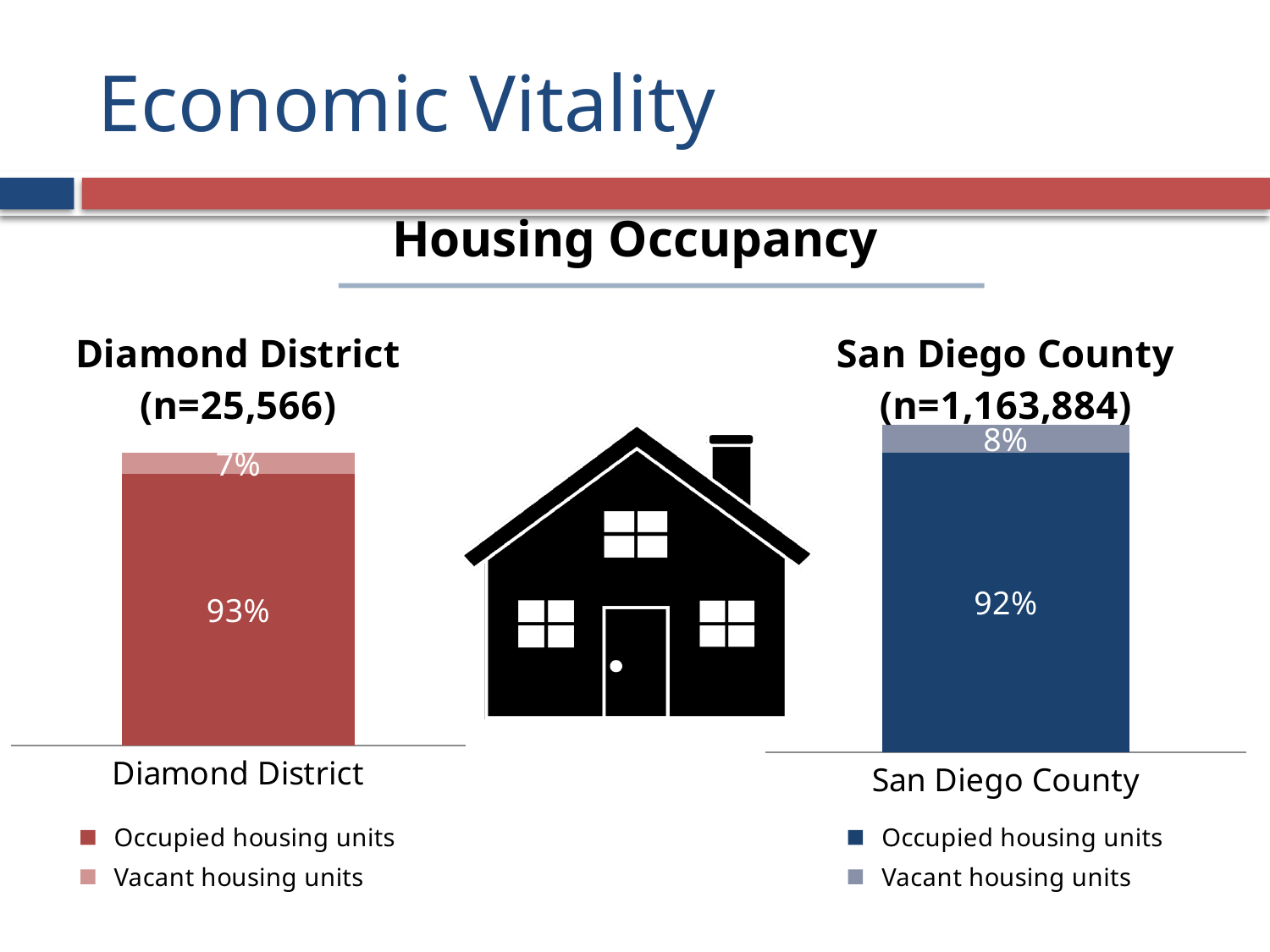
What is the sample size (n) shown for the Diamond District chart? 25,566 What is the sample size (n) shown for the San Diego County chart? 1,163,884 In the San Diego County chart, what percentage of housing units are occupied? 92% How many series does the legend of the San Diego County chart list? 2 In the San Diego County chart, what percentage of housing units are vacant? 8% What kind of chart is the Diamond District chart? Stacked bar chart In the Diamond District chart, what percentage of housing units are occupied? 93% How many bars are in the San Diego County chart? 1 Which has a higher share of occupied housing units, the Diamond District chart or the San Diego County chart? Diamond District What is the difference between the vacant housing unit share in the San Diego County chart and in the Diamond District chart? 1% In the Diamond District chart, what is the total of the stacked bar? 100% In the Diamond District chart, what percentage of housing units are vacant? 7%